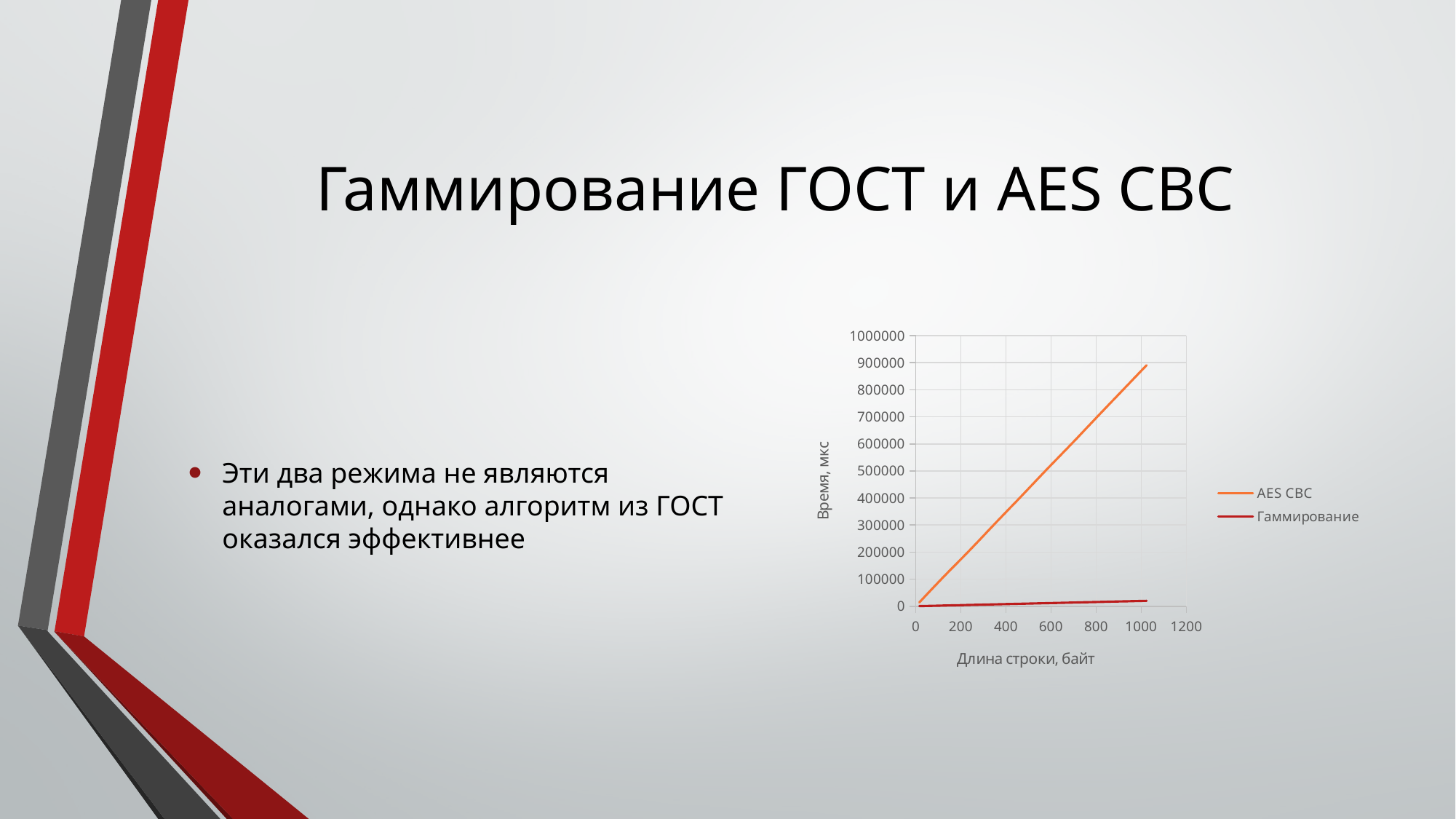
How many series does the chart legend list? 2 Is the value for AES CBC at a string length of 1000 bytes greater or less than 800000? greater Which series has the lower time values across the chart? Гаммирование What is the title of the vertical axis of the chart? Время, мкс Does the AES CBC line rise or fall as the string length increases along the x axis? rise Which series does the chart legend list first? AES CBC Is the value for AES CBC at a string length of 600 bytes greater or less than 700000? less What kind of chart is shown on the slide? line chart Is the value for Гаммирование at a string length of 1000 bytes greater or less than 100000? less What is the highest tick value shown on the vertical axis of the chart? 1000000 Which series reaches the higher time value at the right end of the chart, AES CBC or Гаммирование? AES CBC